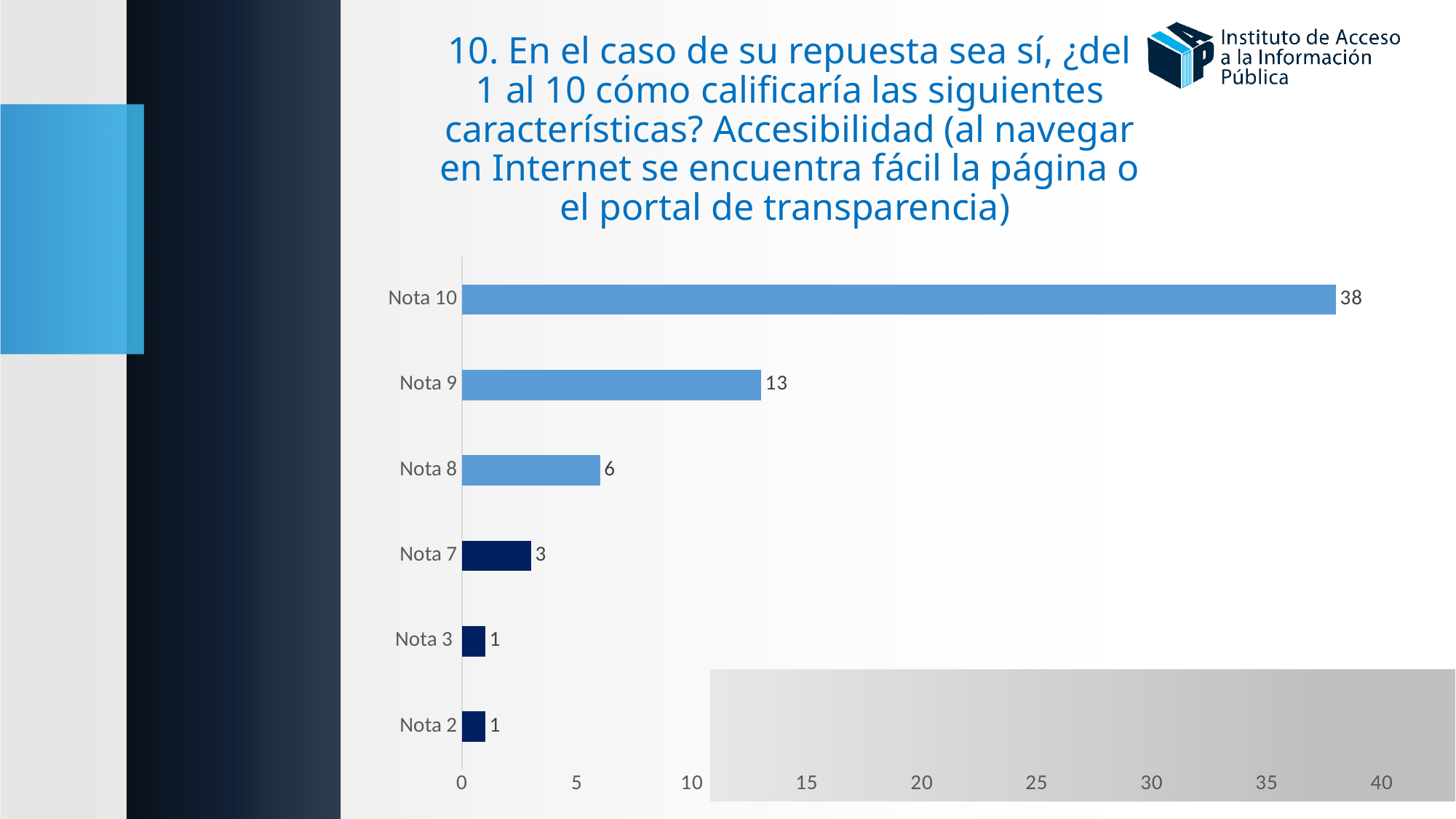
Is the value for Nota 10 greater or less than 35? greater Which category has the highest value? Nota 10 What is the value for Nota 8? 6 What is the difference between the values for Nota 10 and Nota 9? 25 What is the value for Nota 9? 13 Which is larger, the value for Nota 9 or the value for Nota 8? Nota 9 What kind of chart is shown on the slide? Bar chart What is the value for Nota 10? 38 How many categories are shown in the chart? 6 What is the highest value shown on the horizontal axis? 40 What is the value for Nota 7? 3 What is the difference between the values for Nota 8 and Nota 7? 3